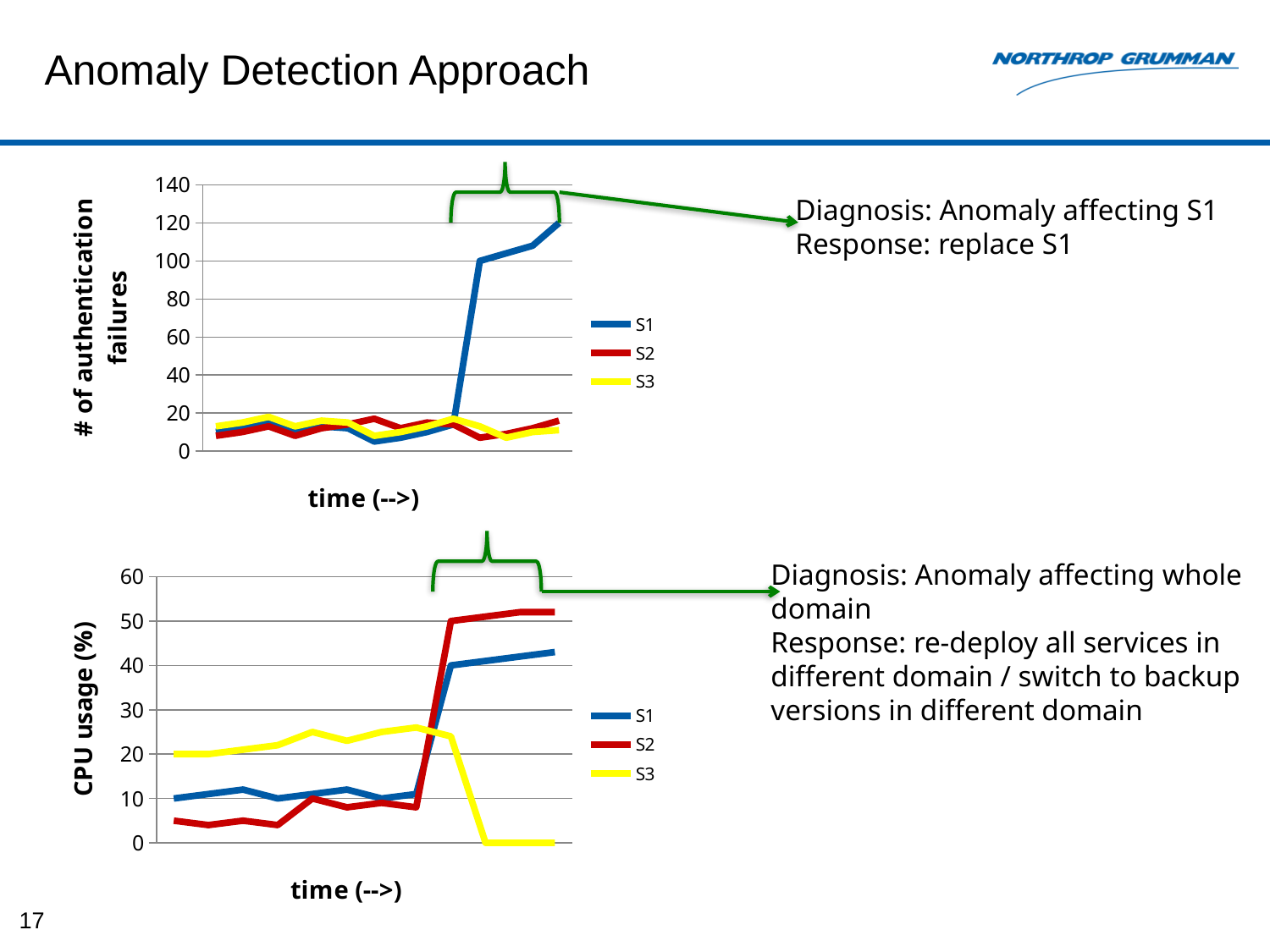
In the bottom chart, is the first value of S2 greater or less than 10? less In the bottom chart, what is the final value of S3? 0 In the bottom chart, is the first value of S3 greater or less than 10? greater In the bottom chart, is the final value of S2 greater or less than 40? greater In the top chart, which series shows a sharp rise at the end of the time axis? S1 How many series does the legend of the top chart list? 3 What is the y-axis label of the top chart? # of authentication failures What kind of chart is the top chart on the slide? line chart In the bottom chart, does the S3 line rise or fall at the end of the time axis? fall What are the legend entries of the bottom chart? S1, S2, S3 In the bottom chart, at the end of the time axis, which series is higher, S1 or S2? S2